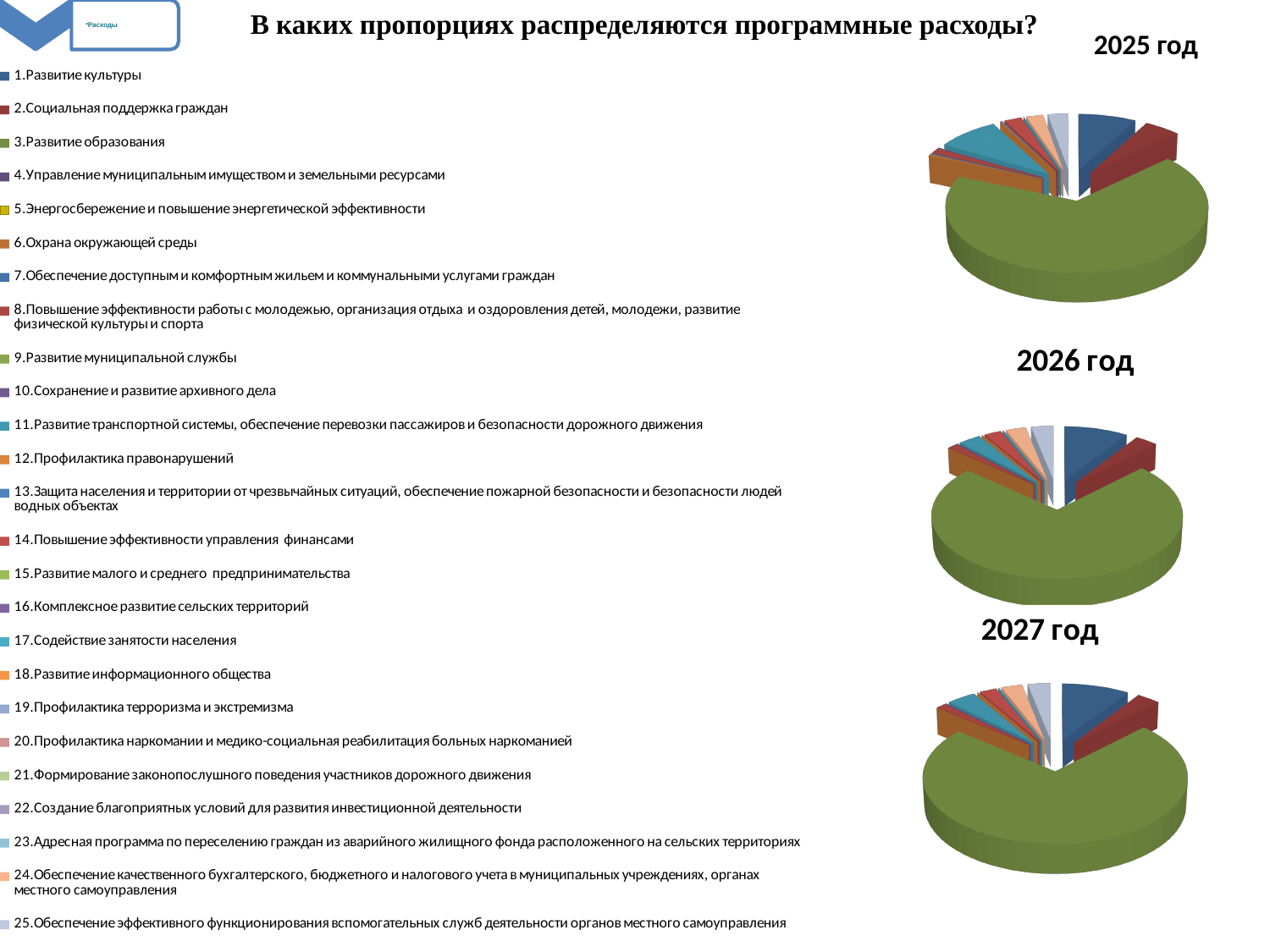
In the 2025 год pie chart, which category has the largest slice? 3.Развитие образования What kind of chart is used for the 2025 год chart? pie chart In the 2027 год pie chart, which category has the largest slice? 3.Развитие образования How many categories are listed in the legend shared by the pie charts? 25 How many pie charts are shown on the slide? 3 In the 2026 год pie chart, which category has the largest slice? 3.Развитие образования Which years are the three pie charts labelled with? 2025 год, 2026 год, 2027 год What is the title of the slide above the pie charts? В каких пропорциях распределяются программные расходы?